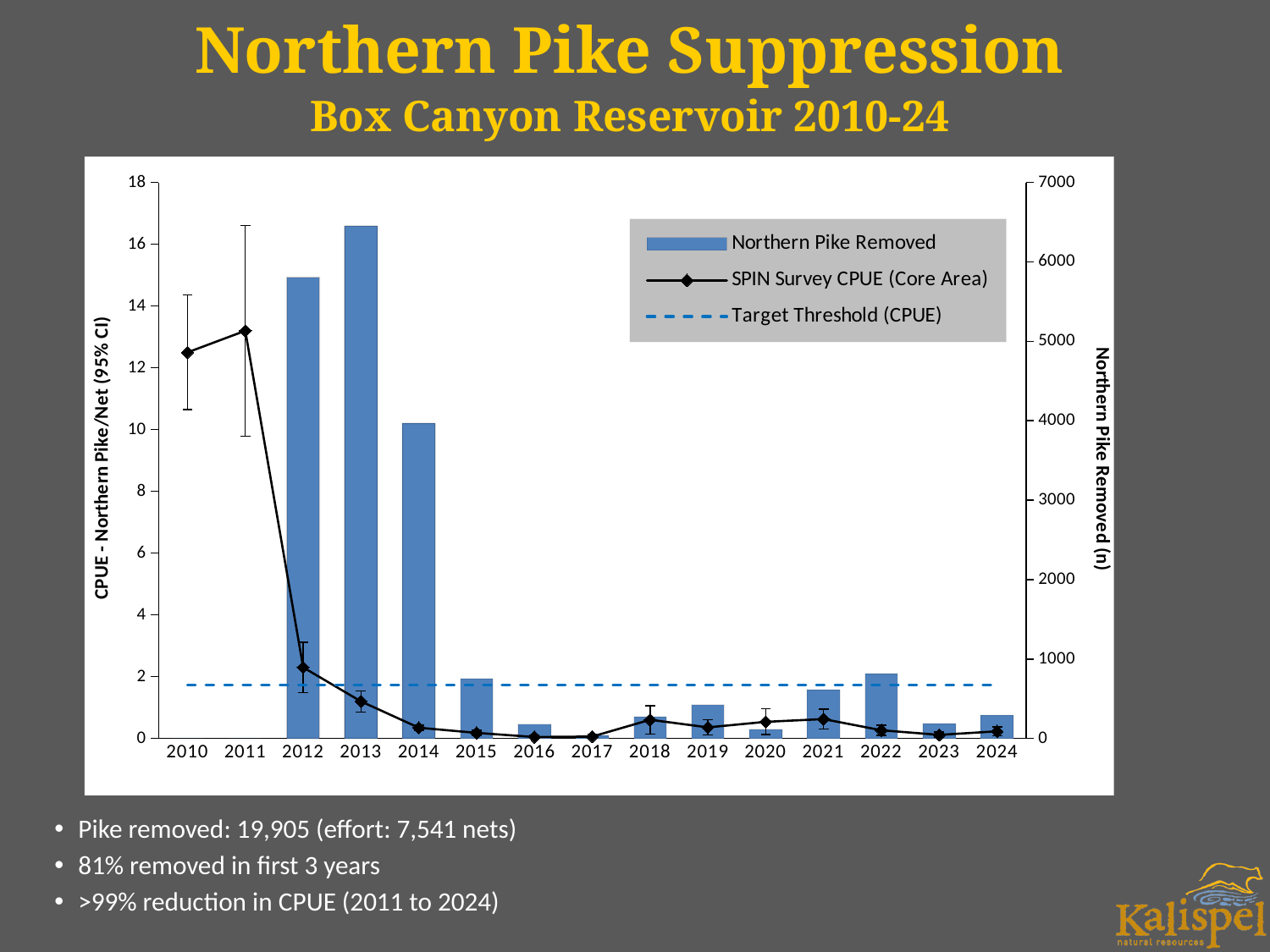
Is the SPIN Survey CPUE (Core Area) value for 2013 greater or less than 2? less What is the title of the right-hand vertical axis? Northern Pike Removed (n) How many series does the legend list? 3 How many years are shown along the x axis? 15 Is the number of Northern Pike Removed in 2012 greater or less than 5000? greater What kind of chart is shown on the slide? A combined bar and line chart Which year had more Northern Pike Removed, 2021 or 2022? 2022 Which year has the highest number of Northern Pike Removed? 2013 Is the number of Northern Pike Removed in 2013 greater or less than 6000? greater Does the SPIN Survey CPUE (Core Area) rise or fall from 2011 to 2017? It falls